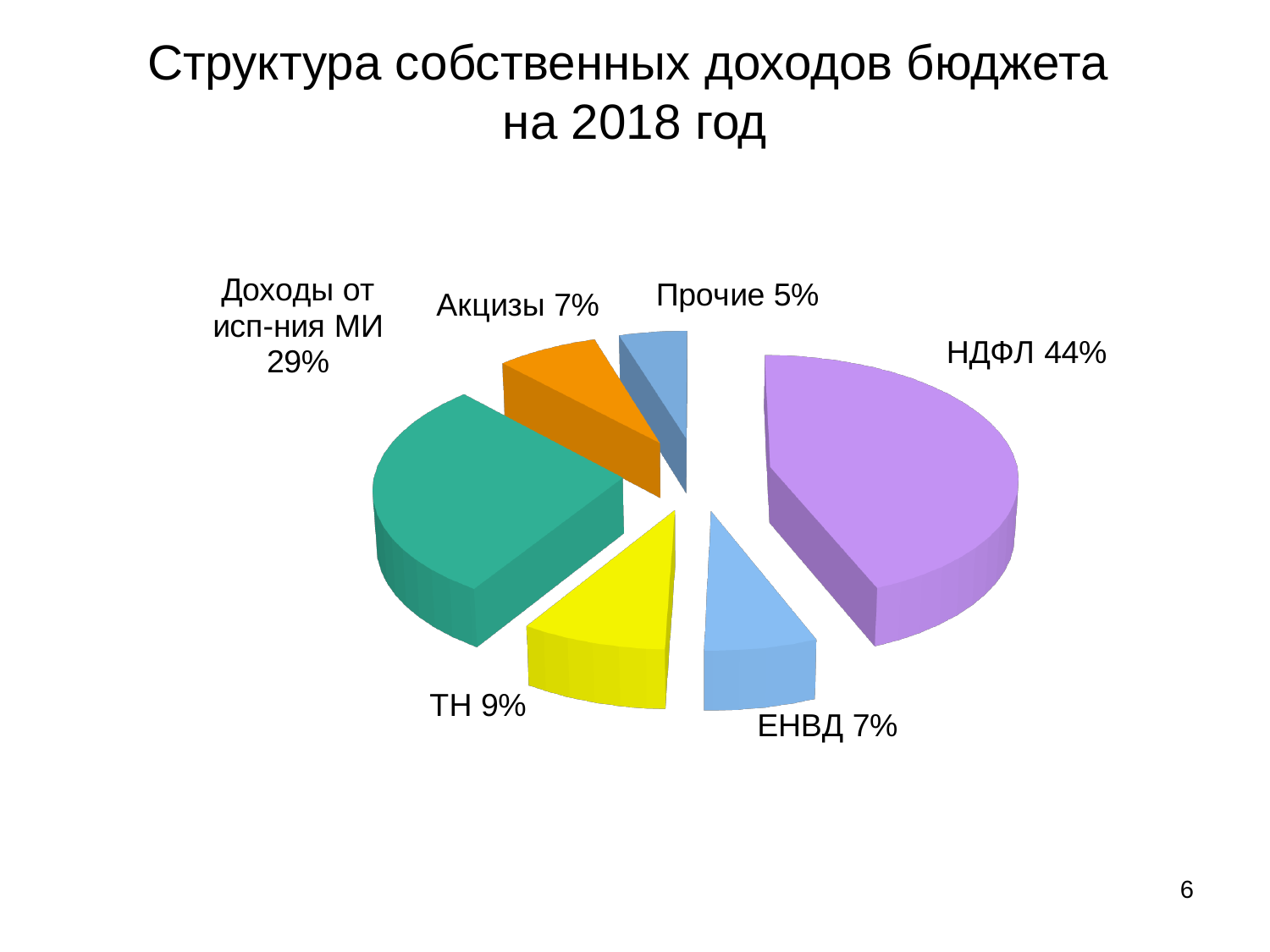
How many slices does the pie chart have? 6 What kind of chart is shown on the slide? Pie chart What share of the pie does Акцизы have? 7% Which category has the smallest share of the pie? Прочие What share of the pie does ТН have? 9% What share of the pie does НДФЛ have? 44% Which category has the largest share of the pie? НДФЛ What share of the pie does Прочие have? 5% Which is larger, the share of ТН or the share of ЕНВД? ТН What share of the pie does Доходы от исп-ния МИ have? 29% What is the title of the slide containing the chart? Структура собственных доходов бюджета на 2018 год What is the difference between the shares of НДФЛ and Доходы от исп-ния МИ? 15%